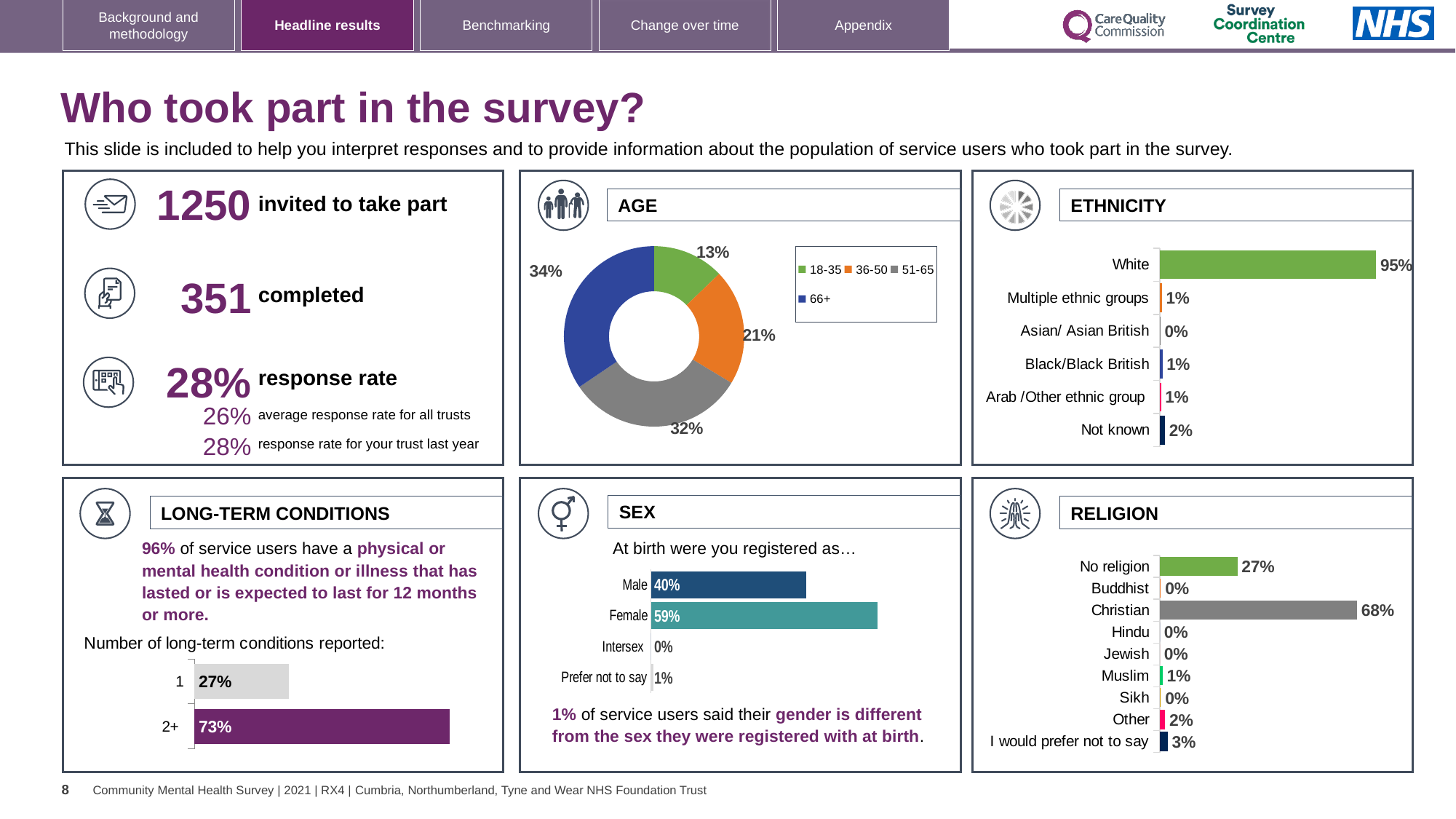
In the ETHNICITY chart, what is the difference between White and Not known? 93% In the SEX chart, which is larger, Male or Female? Female In the ETHNICITY chart, what is the value for White? 95% How many ethnicity categories are shown in the ETHNICITY chart? 6 In the RELIGION chart, which category has the highest value? Christian In the SEX chart, what is the difference between Female and Male? 19% In the AGE chart, which age group has the smallest share? 18-35 What kind of chart is the AGE chart? Donut chart How many categories are shown in the RELIGION chart? 9 In the AGE chart, what percentage of respondents were aged 66+? 34% In the LONG-TERM CONDITIONS chart, what percentage reported 2+ conditions? 73% How many age groups does the legend of the AGE chart list? 4